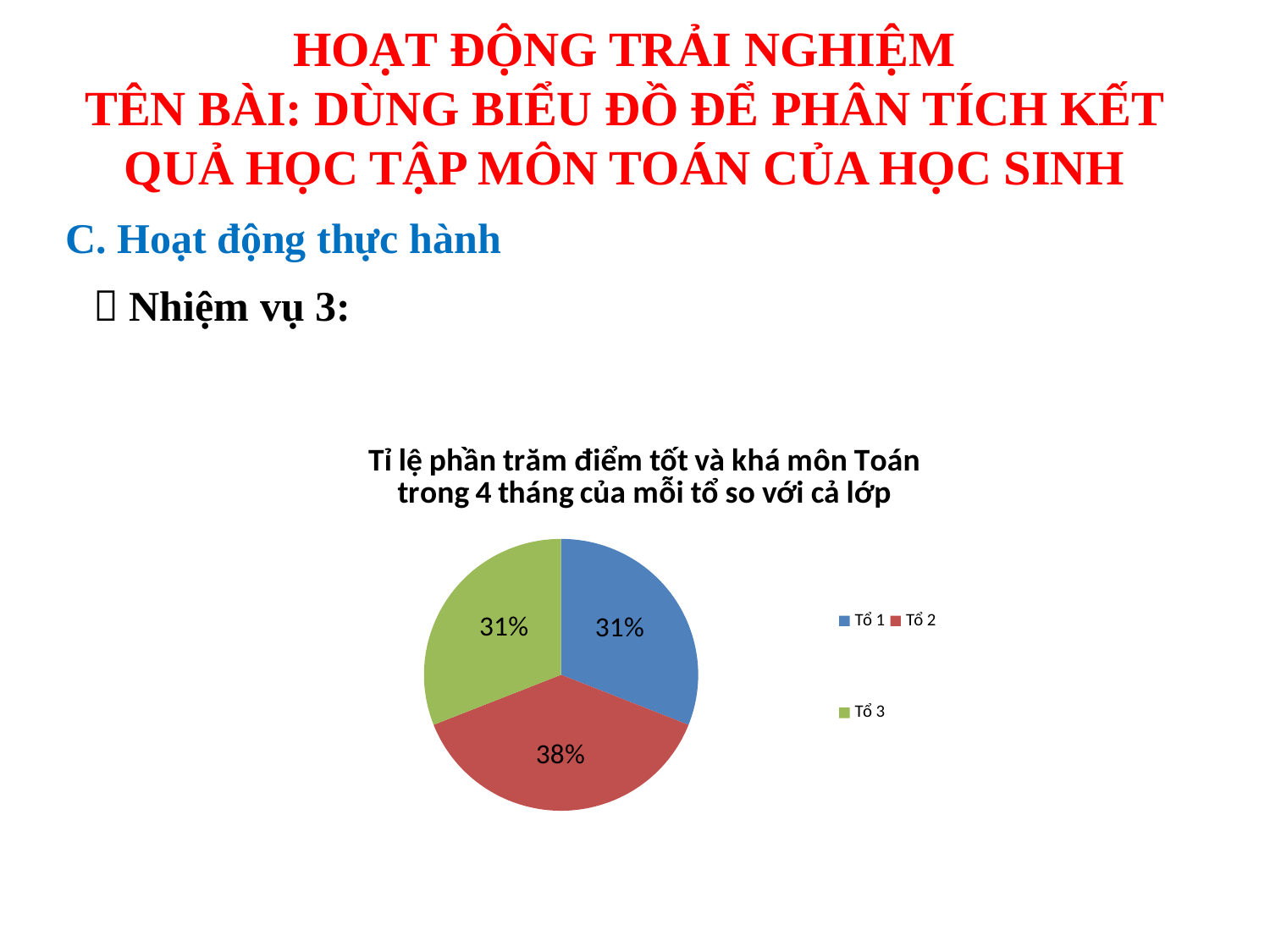
What is the title of the pie chart? Tỉ lệ phần trăm điểm tốt và khá môn Toán trong 4 tháng của mỗi tổ so với cả lớp How many slices does the pie chart have? 3 Which is larger, the slice for Tổ 2 or the slice for Tổ 3? Tổ 2 What colour is the slice for Tổ 3 in the pie chart? Green What share of the pie does Tổ 2 represent? 38% What is the difference in percentage points between Tổ 2 and Tổ 1? 7 percentage points What percentage is shown for Tổ 1 in the pie chart? 31% What type of chart is shown on the slide? Pie chart What percentage is shown for Tổ 2 in the pie chart? 38% How many entries does the legend of the pie chart list? 3 Which tổ has the largest slice of the pie chart? Tổ 2 What percentage is shown for Tổ 3 in the pie chart? 31%